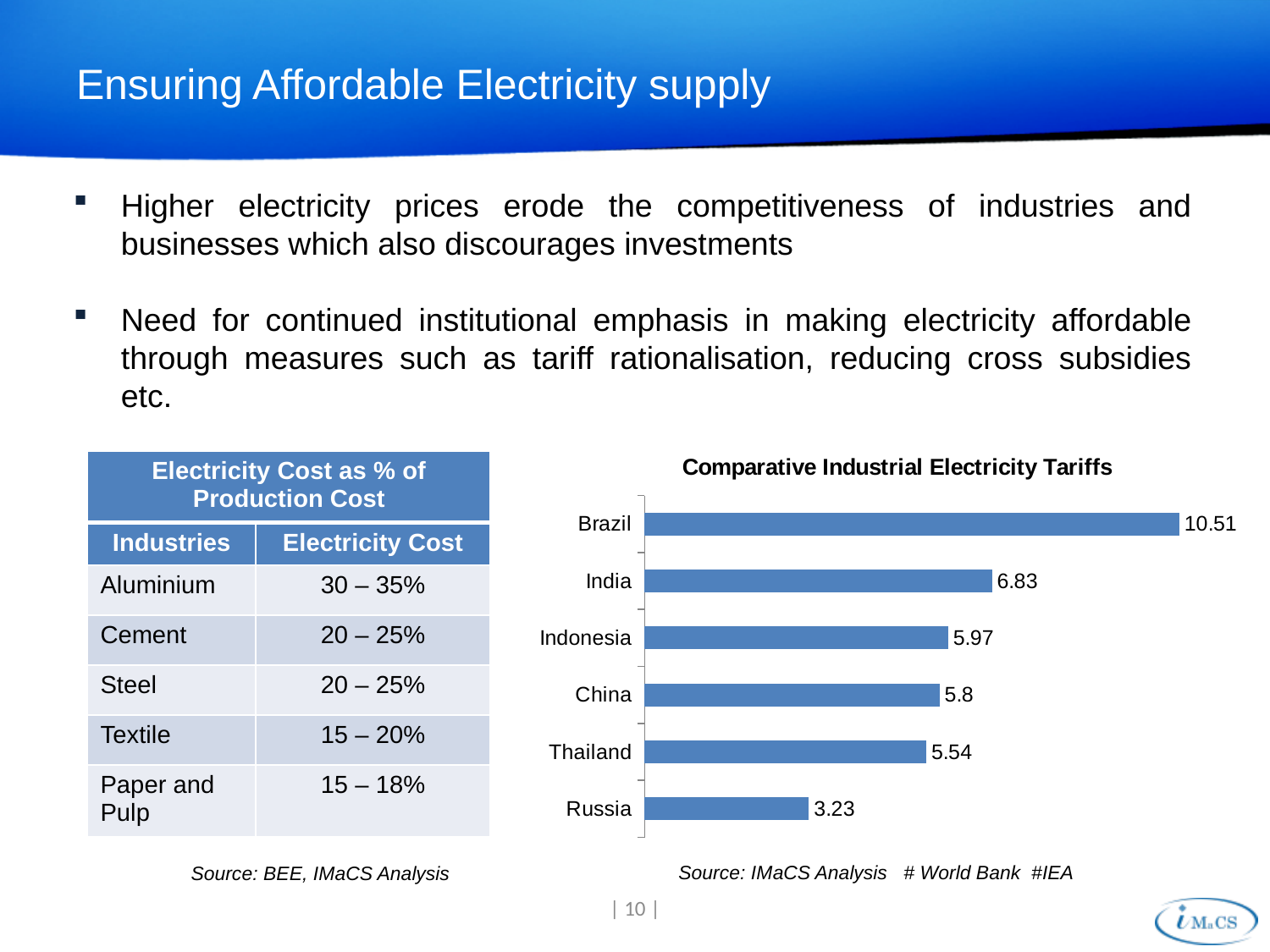
What is the value for Russia in the Comparative Industrial Electricity Tariffs chart? 3.23 What is the difference between the values for Indonesia and China in the Comparative Industrial Electricity Tariffs chart? 0.17 What is the value for Thailand in the Comparative Industrial Electricity Tariffs chart? 5.54 What is the value for India in the Comparative Industrial Electricity Tariffs chart? 6.83 What is the title of the chart on the slide? Comparative Industrial Electricity Tariffs What is the value for Brazil in the Comparative Industrial Electricity Tariffs chart? 10.51 What kind of chart is the Comparative Industrial Electricity Tariffs chart? Bar chart What is the difference between the values for Brazil and India in the Comparative Industrial Electricity Tariffs chart? 3.68 How many countries are shown in the Comparative Industrial Electricity Tariffs chart? 6 Which country has the highest value in the Comparative Industrial Electricity Tariffs chart? Brazil Which country has the lowest value in the Comparative Industrial Electricity Tariffs chart? Russia In the Comparative Industrial Electricity Tariffs chart, which is larger, the value for India or the value for Indonesia? India